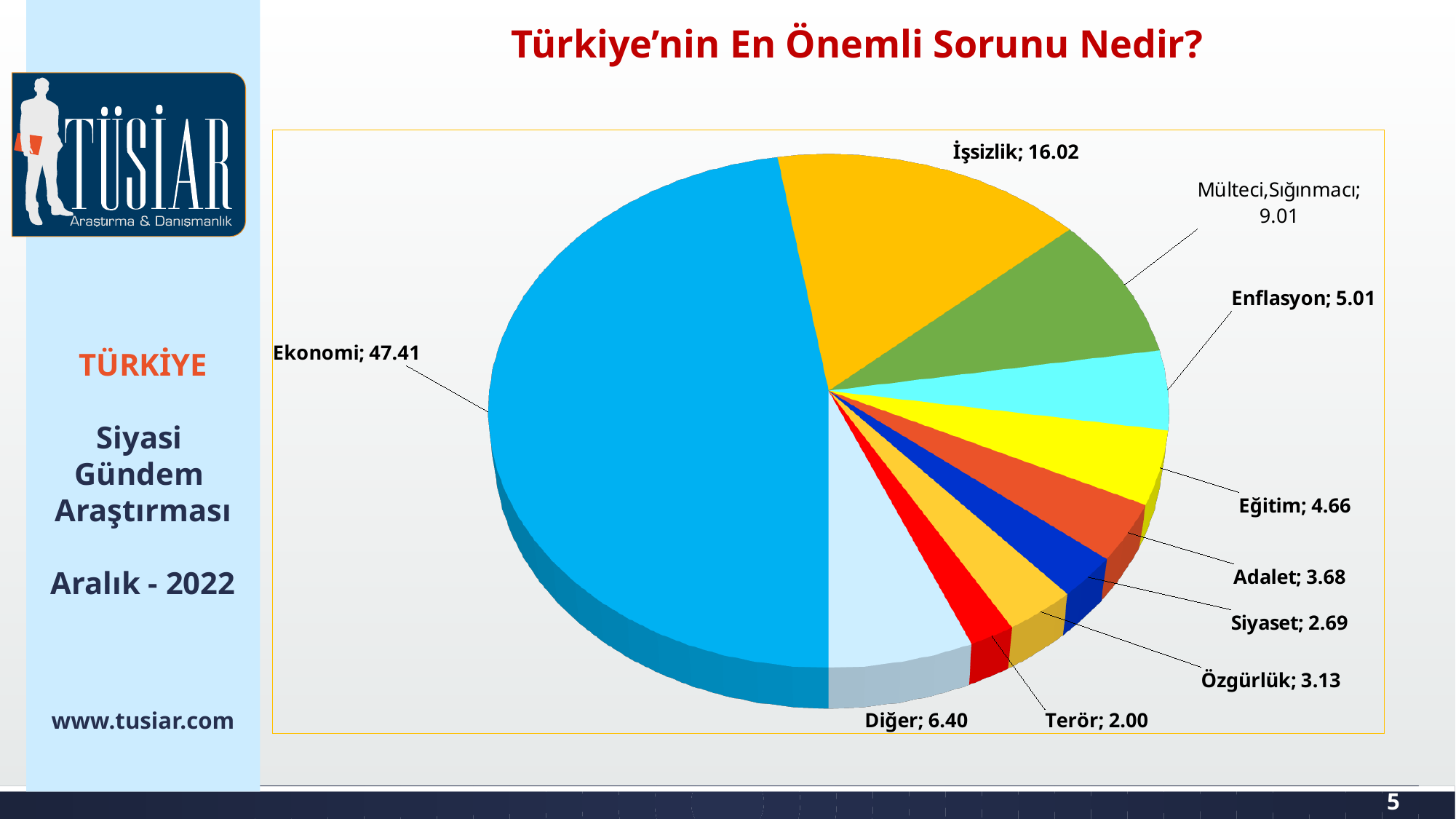
How many categories are shown in the pie chart? 10 What is the value for Mülteci,Sığınmacı? 9.01 What is the difference between the values for Ekonomi and İşsizlik? 31.39 What is the title of the chart? Türkiye'nin En Önemli Sorunu Nedir? What is the value for İşsizlik? 16.02 Which is larger, Enflasyon or Eğitim? Enflasyon What kind of chart is shown on the slide? Pie chart What is the value for Ekonomi? 47.41 Which category has the smallest slice? Terör What is the difference between the values for Özgürlük and Siyaset? 0.44 Which category has the largest slice? Ekonomi What is the value for Terör? 2.00